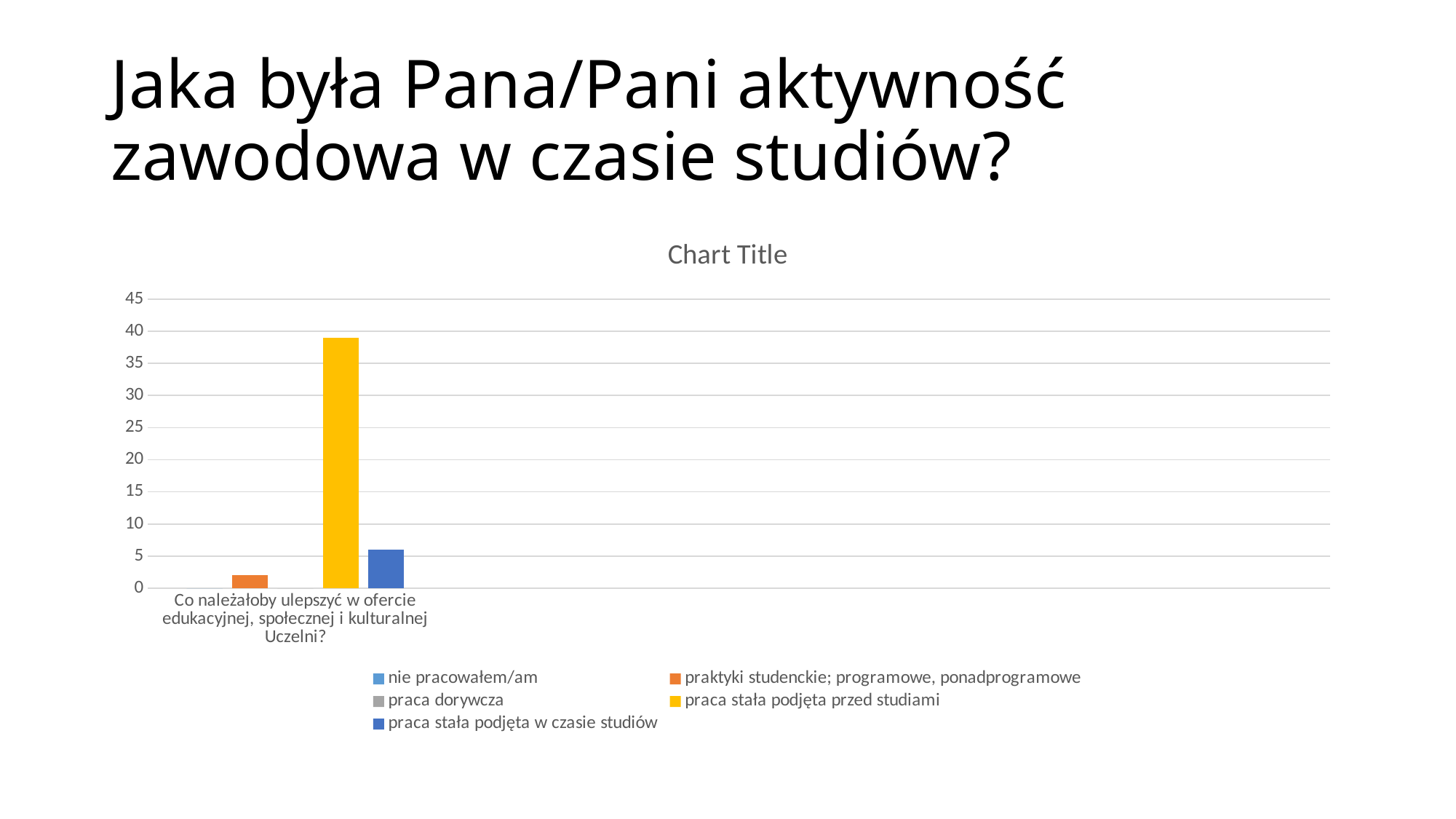
How many series does the legend list? 5 Which series has the highest value? praca stała podjęta przed studiami Is the value for praca stała podjęta przed studiami greater or less than 40? less Which is larger: the value for praca stała podjęta przed studiami or the value for praca stała podjęta w czasie studiów? praca stała podjęta przed studiami Is the value for praktyki studenckie; programowe, ponadprogramowe greater or less than 5? less What is the title shown above the chart? Chart Title What kind of chart is shown on the slide? bar chart Is the value for praca stała podjęta w czasie studiów greater or less than 10? less How many categories are shown on the x axis? 1 What colour represents praca stała podjęta przed studiami in the legend? yellow Which is larger: the value for praktyki studenckie; programowe, ponadprogramowe or the value for praca stała podjęta w czasie studiów? praca stała podjęta w czasie studiów